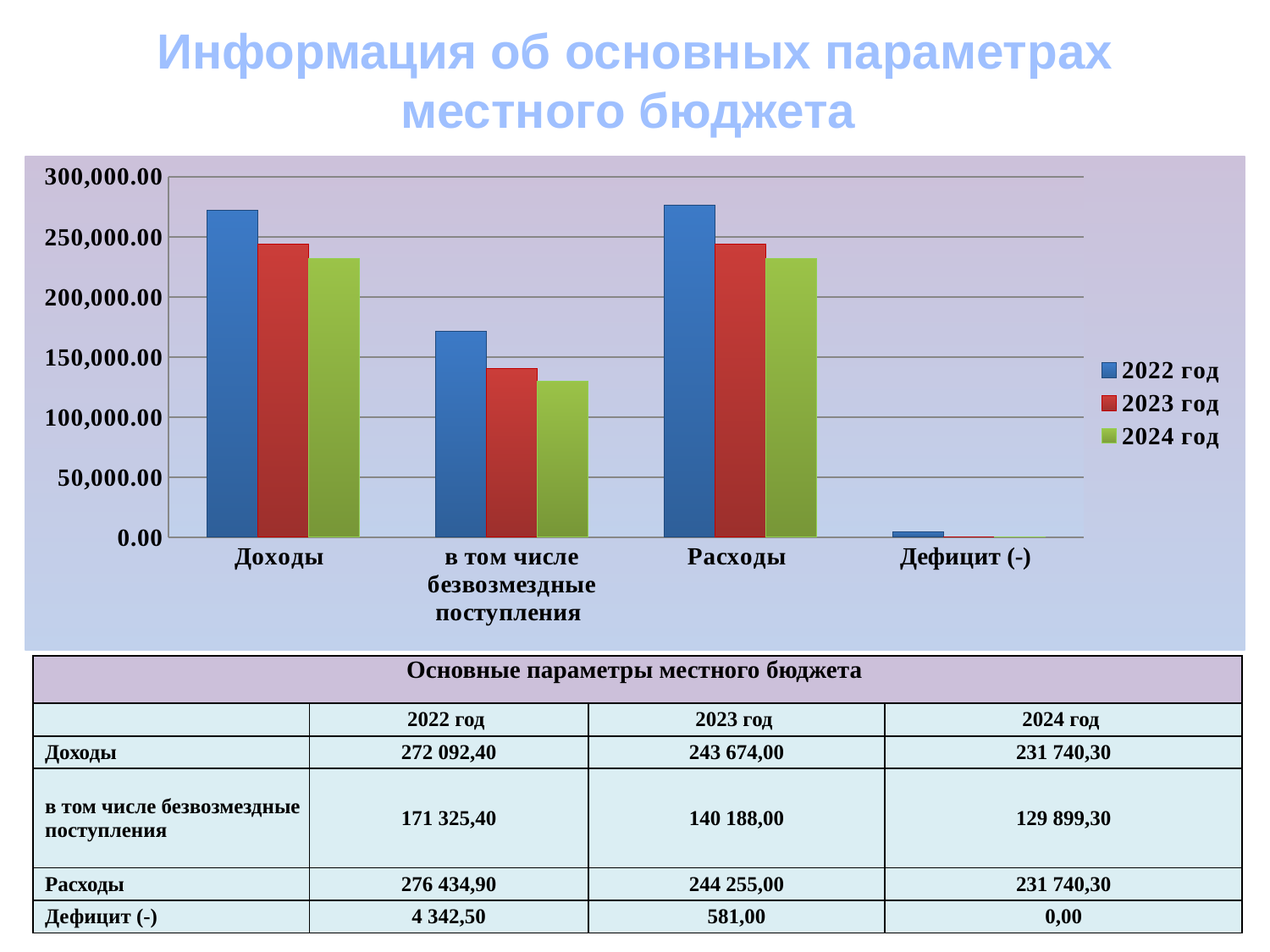
Is the value of в том числе безвозмездные поступления for 2024 год greater or less than 150,000.00? less What is the value of Дефицит (-) for 2024 год? 0,00 Which category has the tallest bar for 2022 год? Расходы How many categories are shown on the x axis of the chart? 4 Do the values for Доходы rise or fall from 2022 год to 2024 год? fall What kind of chart is shown on the slide? bar chart Which is larger: Доходы for 2022 год or Доходы for 2023 год? 2022 год Which category has the lowest values across all three years? Дефицит (-) What is the value of Расходы for 2023 год? 244 255,00 How many series does the chart legend list? 3 What is the difference between Расходы and Доходы for 2022 год? 4 342,50 What is the value of Доходы for 2022 год? 272 092,40